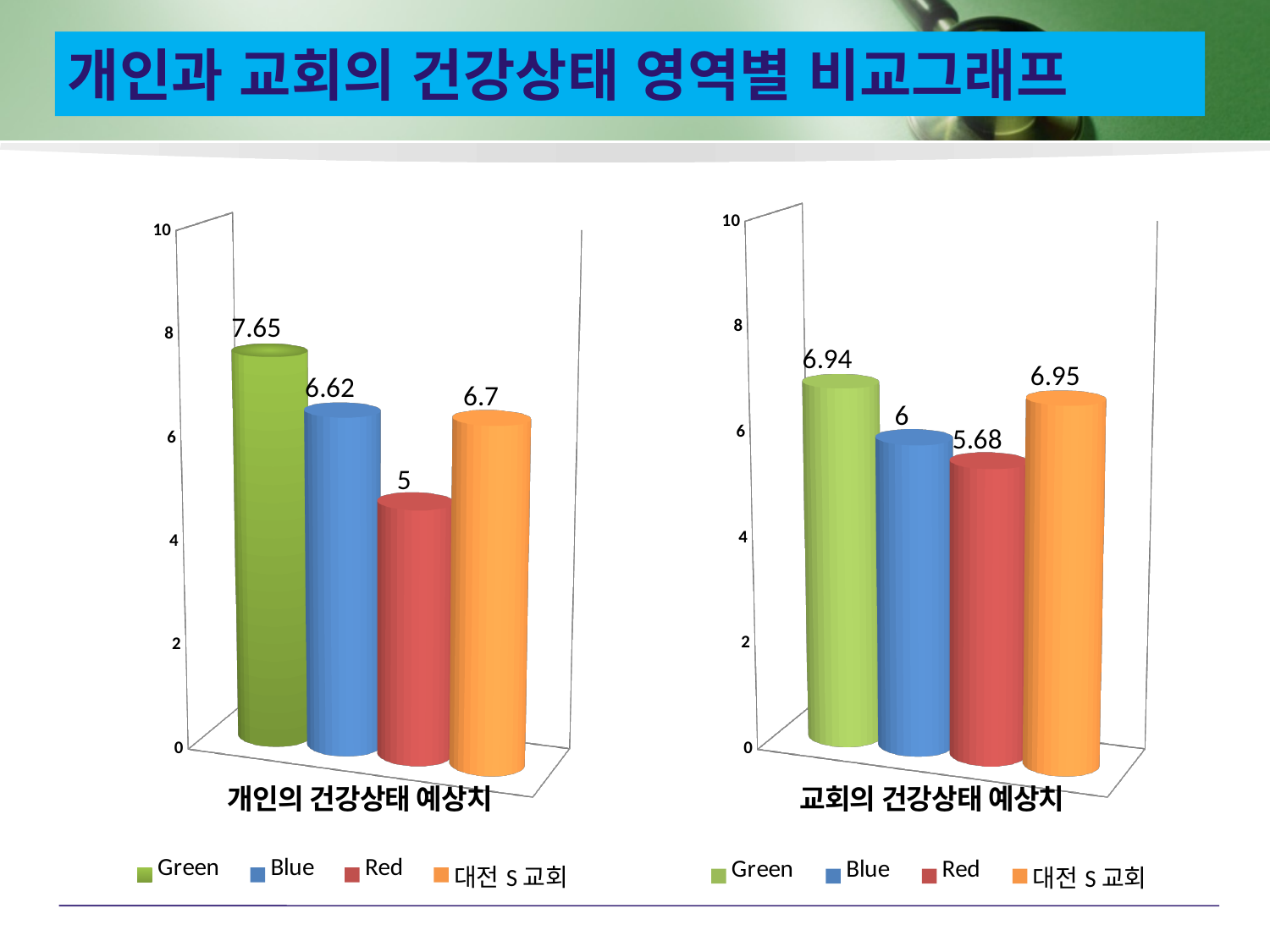
How many series does the legend of the right chart (교회의 건강상태 예상치) list? 4 In the right chart (교회의 건강상태 예상치), what is the value for Blue? 6 In the right chart (교회의 건강상태 예상치), which series has the lowest value? Red In the left chart (개인의 건강상태 예상치), what is the value for 대전 S 교회? 6.7 In the left chart (개인의 건강상태 예상치), what is the difference between the Green value and the Red value? 2.65 In the left chart (개인의 건강상태 예상치), which series has the lowest value? Red In the right chart (교회의 건강상태 예상치), what is the difference between the 대전 S 교회 value and the Blue value? 0.95 What kind of chart is the left chart (개인의 건강상태 예상치)? Bar chart In the left chart (개인의 건강상태 예상치), which series has the highest value? Green In the left chart (개인의 건강상태 예상치), what is the value for Green? 7.65 In the left chart (개인의 건강상태 예상치), which is larger, the Blue value or the 대전 S 교회 value? 대전 S 교회 In the right chart (교회의 건강상태 예상치), what is the value for Red? 5.68